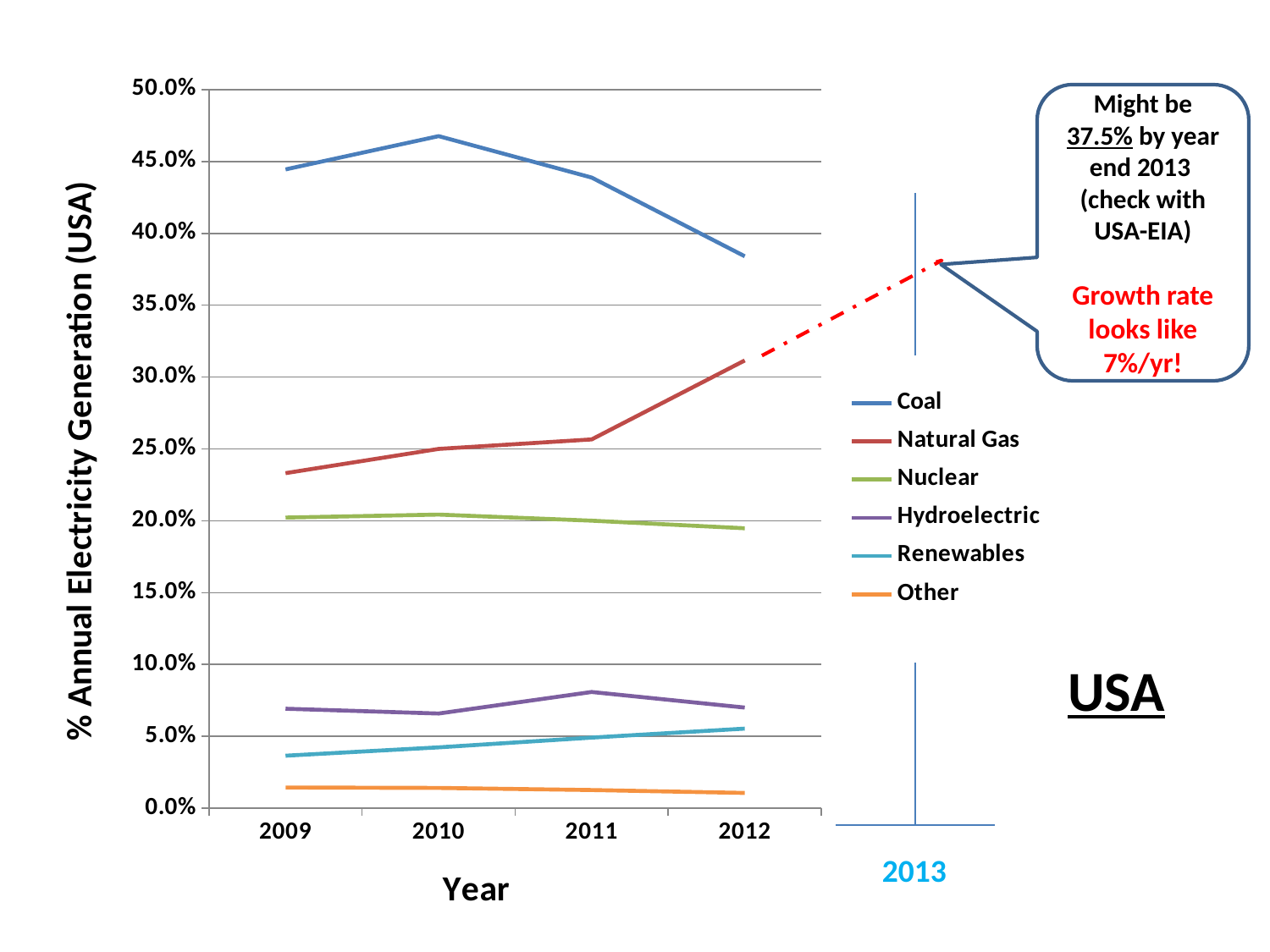
Which is larger in 2012, Nuclear or Hydroelectric? Nuclear Which series has the lowest value in 2012? Other What kind of chart is shown on the slide? line chart Is the value for Hydroelectric in 2011 greater or less than 10.0%? less Which series has the highest value in 2012? Coal Is the value for Natural Gas in 2012 greater or less than 30.0%? greater How many series does the legend list? 6 Does the Natural Gas line rise or fall from 2009 to 2012? rise Is the value for Coal in 2010 greater or less than 45.0%? greater How many years are plotted on the x axis of the chart? 4 What is the title of the y axis? % Annual Electricity Generation (USA)